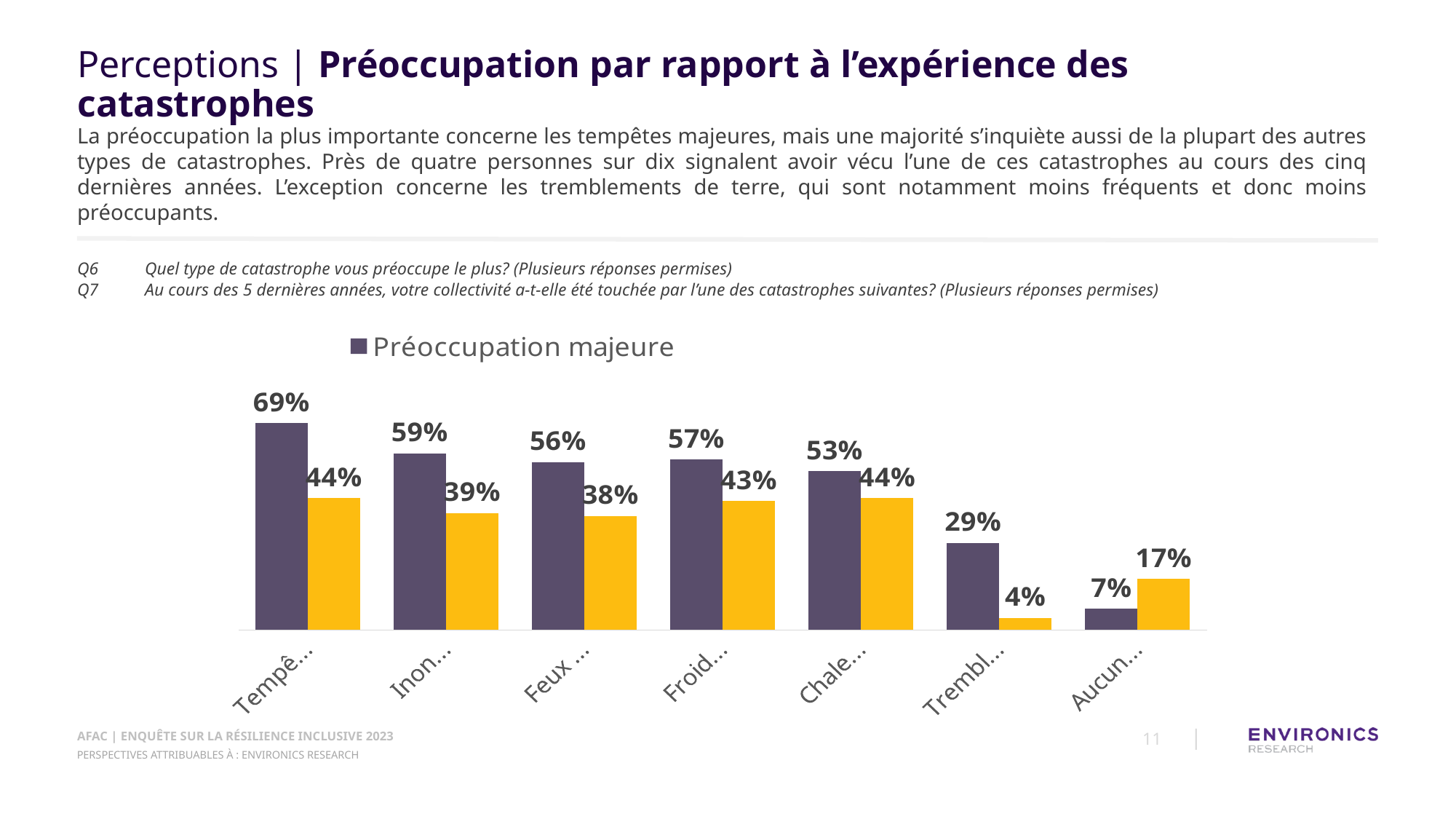
Which category has the highest 'Préoccupation majeure' value? Tempê... What is the 'Préoccupation majeure' value for the first category, labelled 'Tempê...'? 69% Which is larger: the 'Préoccupation majeure' value for 'Inon...' or for 'Chale...'? Inon... What is the difference between the purple and yellow bars for the category labelled 'Tempê...'? 25 percentage points How many series does the chart's legend list? 1 What type of chart is shown on the slide? bar chart How many categories are shown along the x axis of the chart? 7 What is the value of the yellow bar for the category labelled 'Aucun...'? 17% Which category has the lowest value among the yellow bars? Trembl... What is the name of the series listed in the chart's legend? Préoccupation majeure What is the 'Préoccupation majeure' value for the category labelled 'Trembl...'? 29% Which category has the lowest 'Préoccupation majeure' value? Aucun...